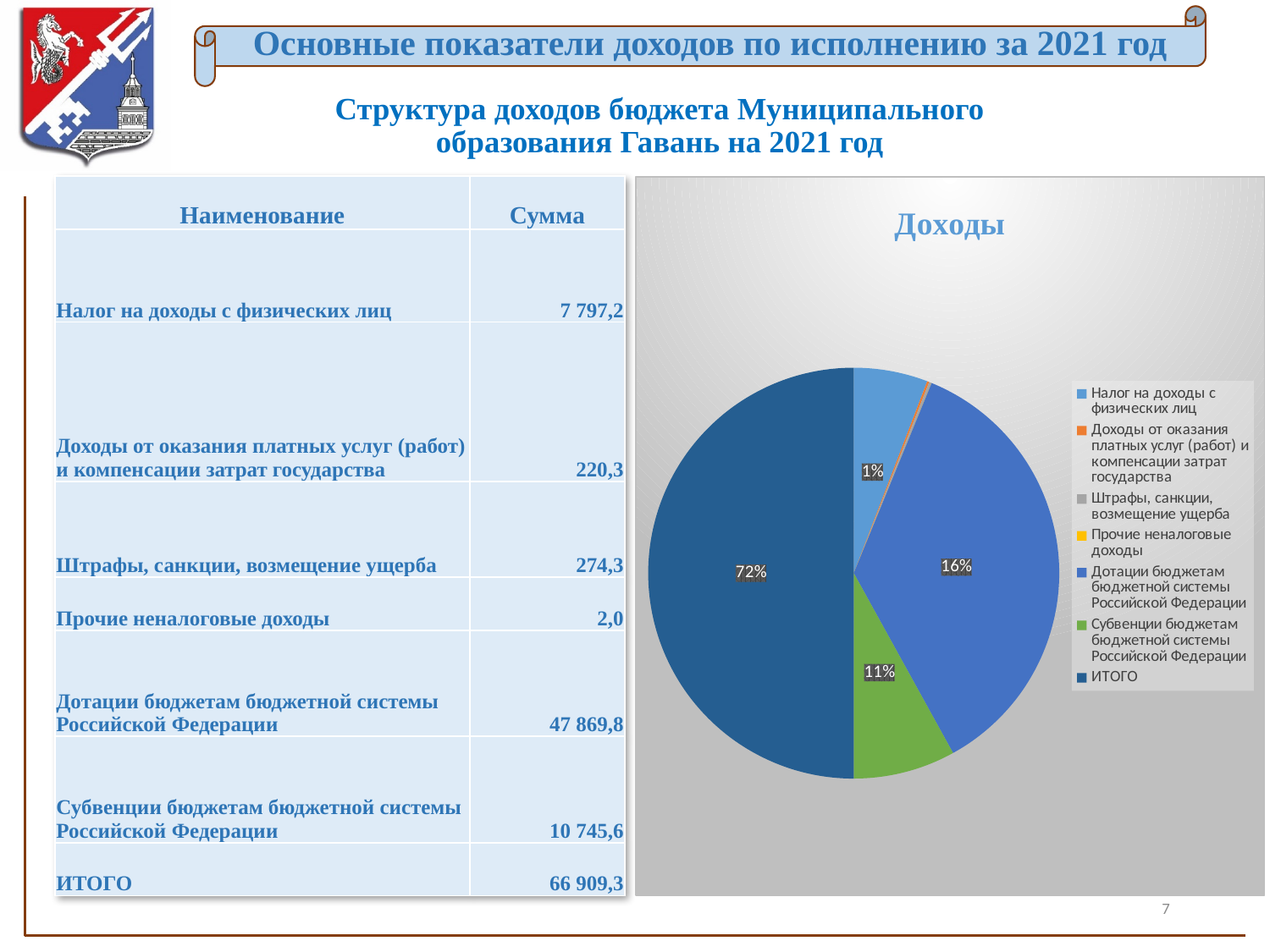
What is the title of the pie chart? Доходы What colour is the slice labelled 11% in the pie chart? green What is the smallest percentage label printed on the pie chart? 1% What share of the pie is labelled for Субвенции бюджетам бюджетной системы Российской Федерации? 11% What kind of chart is shown on the slide? pie chart By how many percentage points does the Дотации slice (16%) exceed the Субвенции slice (11%)? 5 Which legend category corresponds to the largest slice of the pie chart? ИТОГО What share of the pie is labelled for Дотации бюджетам бюджетной системы Российской Федерации? 16% Which slice is larger: Дотации бюджетам бюджетной системы Российской Федерации or Субвенции бюджетам бюджетной системы Российской Федерации? Дотации бюджетам бюджетной системы Российской Федерации What percentage is shown on the largest slice of the pie chart? 72% How many entries does the legend of the pie chart list? 7